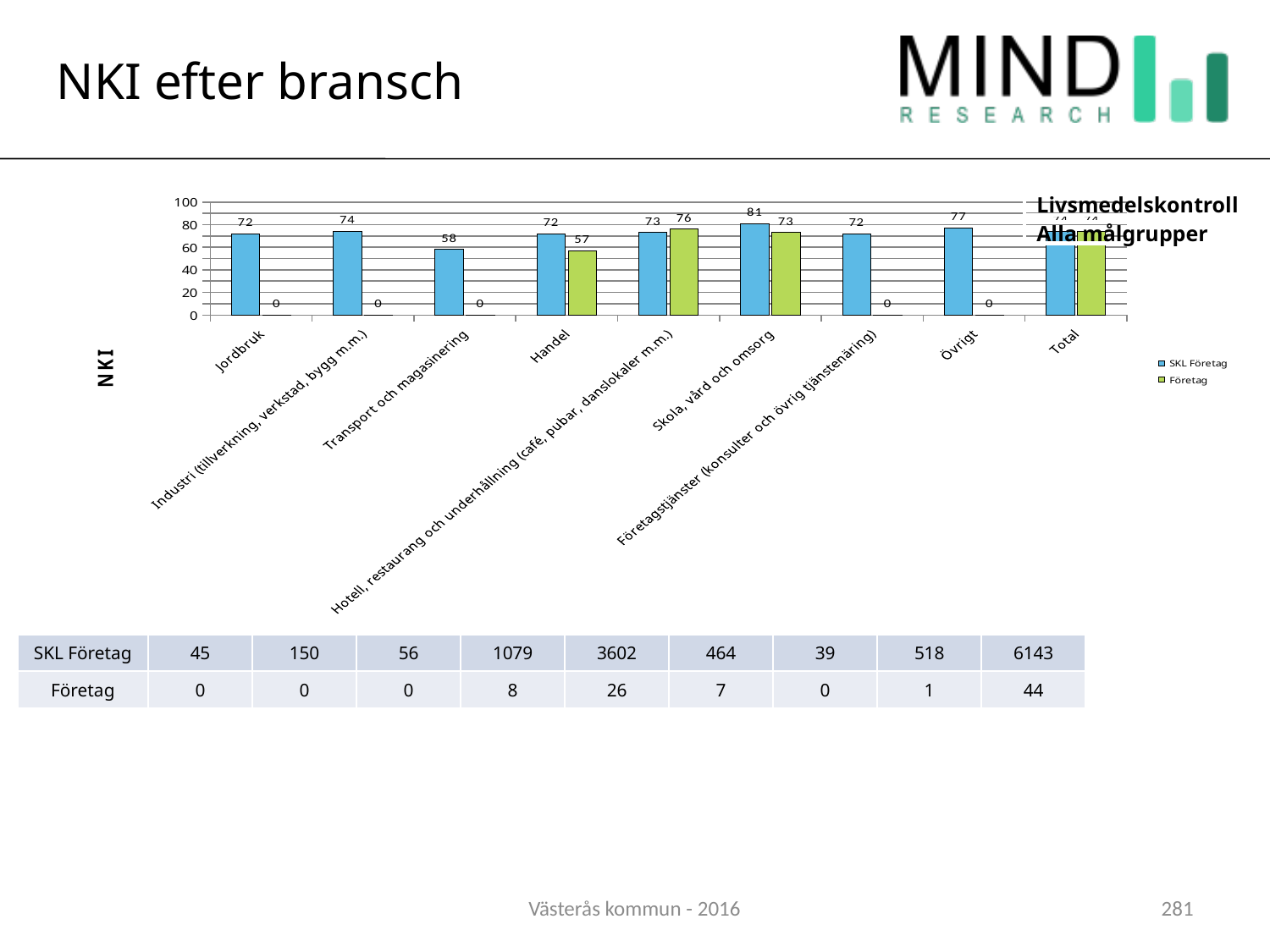
How many series does the legend list? 2 What is the Företag value for Handel? 57 For Hotell, restaurang och underhållning, which series has the larger value, SKL Företag or Företag? Företag What is the SKL Företag value for Skola, vård och omsorg? 81 What is the SKL Företag value for Övrigt? 77 Which category has the lowest SKL Företag value? Transport och magasinering Which category has the highest SKL Företag value? Skola, vård och omsorg What is the SKL Företag value for Jordbruk? 72 For Skola, vård och omsorg, what is the difference between the SKL Företag value and the Företag value? 8 What is the Företag value for Hotell, restaurang och underhållning (café, pubar, danslokaler m.m.)? 76 Is the SKL Företag value for Transport och magasinering greater or less than 60? less What kind of chart is shown on the slide? bar chart